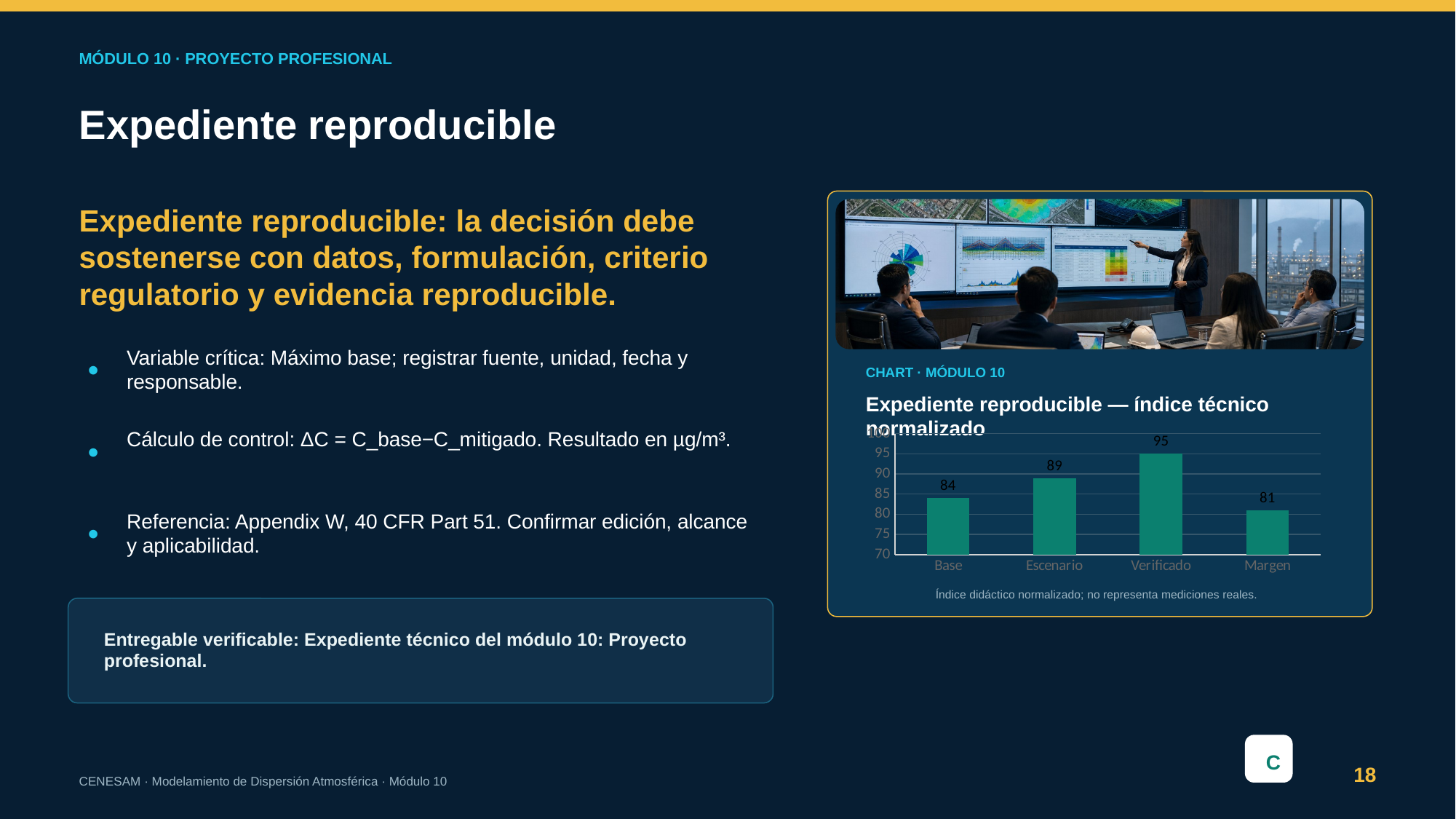
What is the value for Base? 84 What is the difference between the values for Verificado and Base? 11 What is the value for Margen? 81 Which category has the lowest value? Margen What kind of chart is shown? Bar chart What is the difference between the values for Escenario and Margen? 8 What is the title of the chart? Expediente reproducible — índice técnico normalizado How many categories are shown on the x axis? 4 What is the value for Verificado? 95 Which is larger, the value for Escenario or the value for Base? Escenario What is the value for Escenario? 89 Which category has the highest value? Verificado